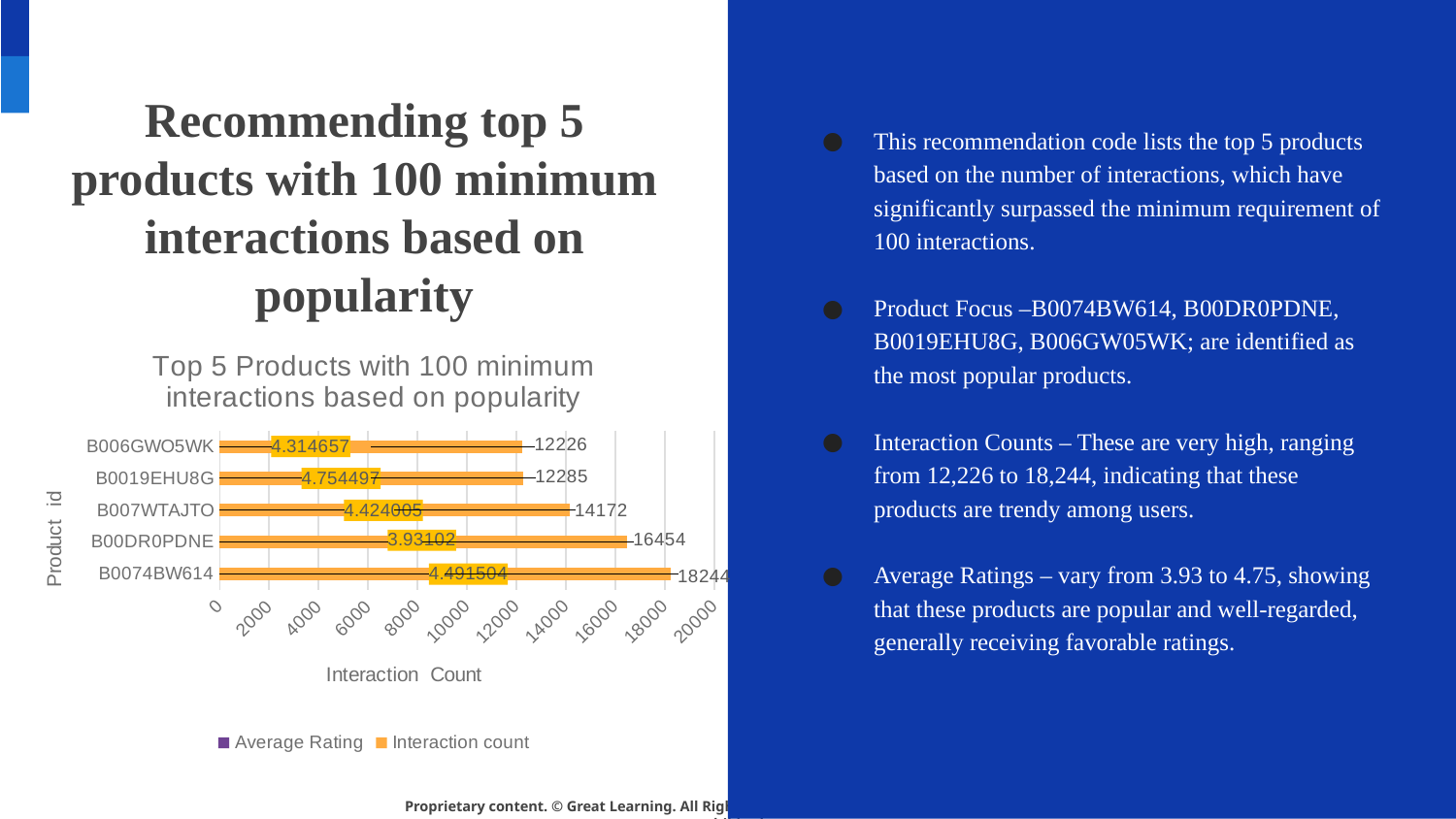
Which product has a higher interaction count, B007WTAJTO or B0019EHU8G? B007WTAJTO How many series does the legend list? 2 What is the average rating shown for product B0019EHU8G? 4.754497 What is the interaction count for product B006GWO5WK? 12226 What type of chart is shown on the slide? Bar chart How many products are shown on the chart? 5 Which product has the highest interaction count? B0074BW614 What is the difference in interaction count between B0074BW614 and B00DR0PDNE? 1790 What is the average rating shown for product B00DR0PDNE? 3.93102 Which product has the lowest interaction count? B006GWO5WK What is the interaction count for product B0074BW614? 18244 Is the interaction count for B00DR0PDNE greater or less than 16000? greater